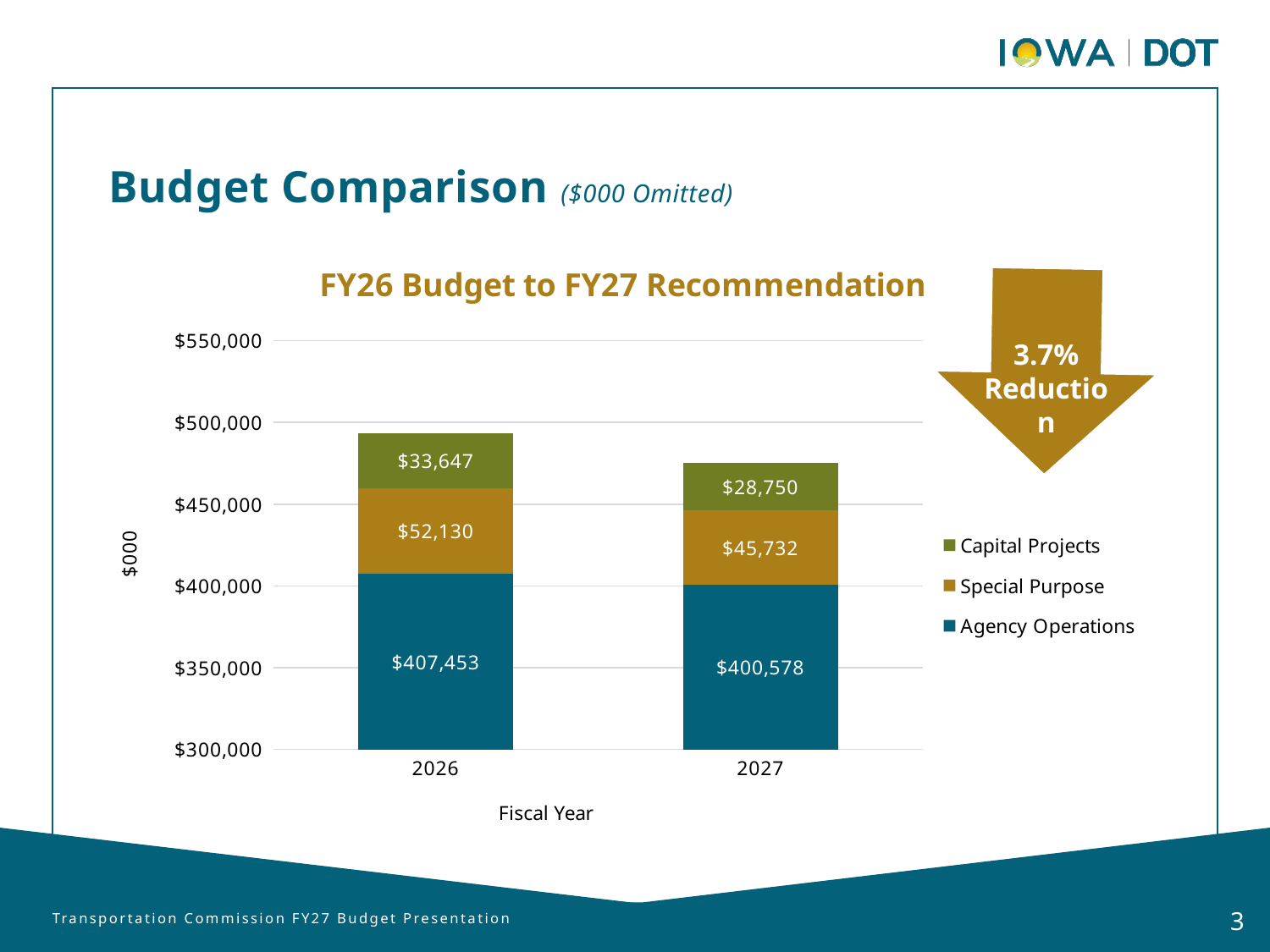
What is the value for Special Purpose in fiscal year 2027? $45,732 Which fiscal year has the larger Capital Projects value, 2026 or 2027? 2026 What is the difference between the Special Purpose values for 2026 and 2027? $6,398 What is the title of the chart? FY26 Budget to FY27 Recommendation What is the total of the stacked bar for fiscal year 2026? $493,230 What is the total of the stacked bar for fiscal year 2027? $475,060 What is the value for Capital Projects in fiscal year 2026? $33,647 What is the value for Capital Projects in fiscal year 2027? $28,750 How many series does the legend list? 3 What kind of chart is shown on the slide? Stacked bar chart What is the value for Agency Operations in fiscal year 2026? $407,453 What is the difference between the Agency Operations values for 2026 and 2027? $6,875